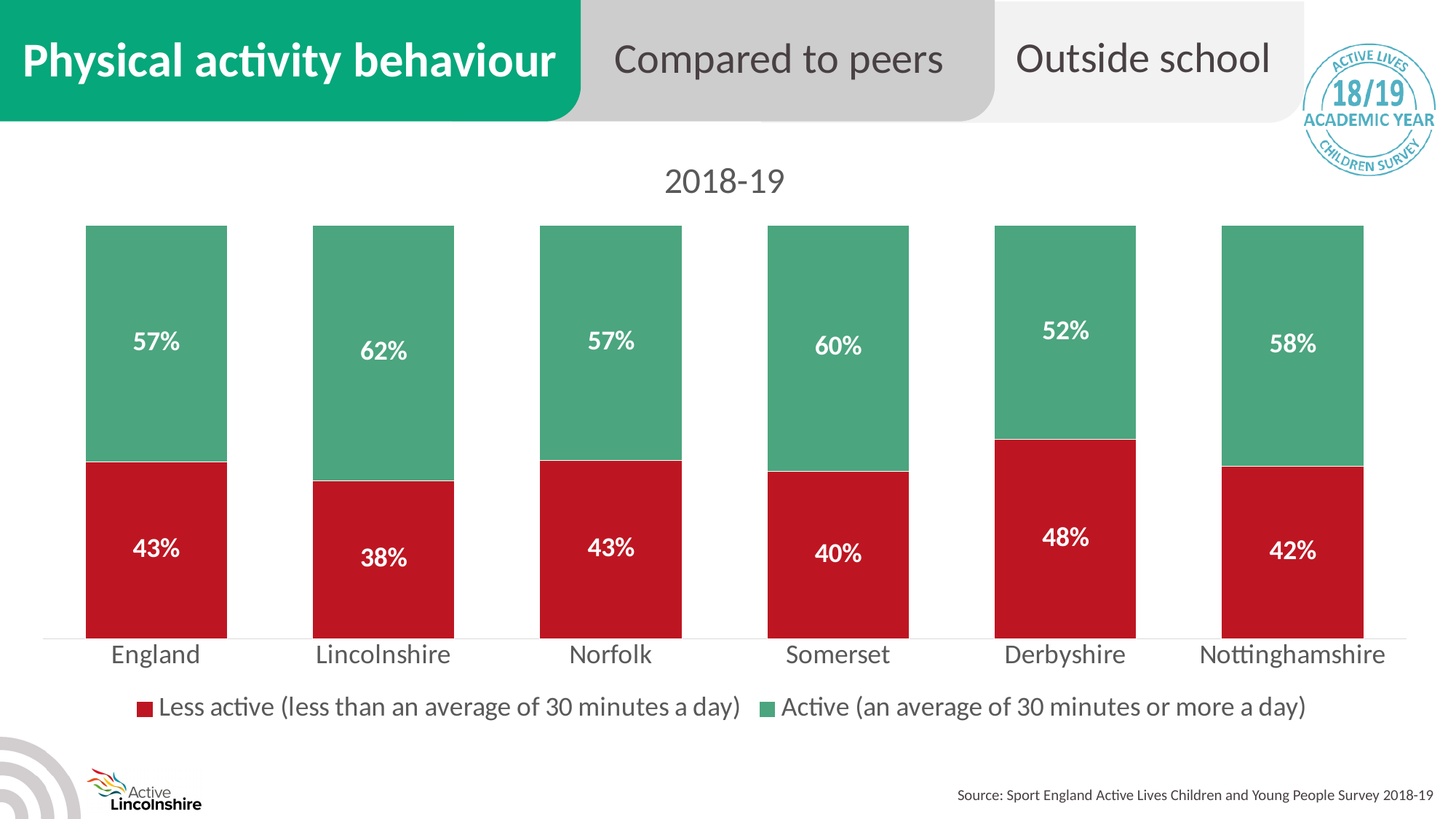
Which area has the lowest Less active percentage? Lincolnshire What is the Active percentage for Somerset? 60% Which area has the lowest Active percentage? Derbyshire Which area has the highest Active percentage? Lincolnshire How many series does the legend list? 2 What kind of chart is shown on the slide? Stacked bar chart What is the title of the chart? 2018-19 Is the Active percentage higher for Nottinghamshire or for Derbyshire? Nottinghamshire How many areas are shown on the x axis? 6 What percentage of children in Lincolnshire are Active (an average of 30 minutes or more a day)? 62% What is the difference between the Active percentage for Lincolnshire and for England? 5% What percentage of children in Derbyshire are Less active (less than an average of 30 minutes a day)? 48%